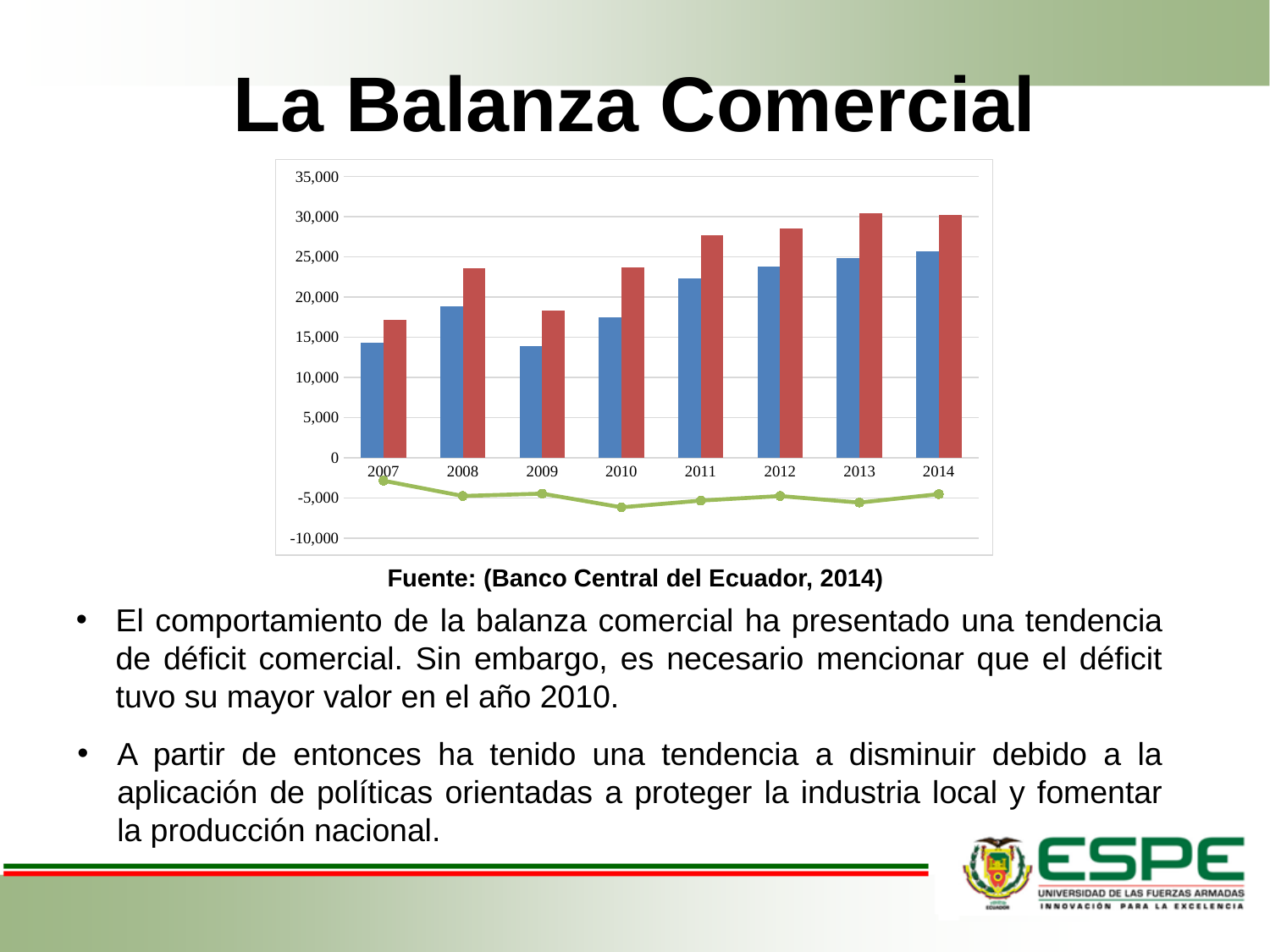
Is the value of the green line for 2010 greater or less than -5,000? less Is the value of the red bar for 2009 greater or less than 20,000? less Do the blue bars rise or fall from 2010 to 2014? rise Is the value of the red bar for 2007 greater or less than 15,000? greater In 2010, which bar is taller, the blue bar or the red bar? the red bar What is the first year shown on the x axis of the chart? 2007 In which year is the red bar the lowest? 2007 In which year does the green line reach its lowest point? 2010 What kind of chart is shown on the slide? bar chart with a line How many years are shown on the x axis of the chart? 8